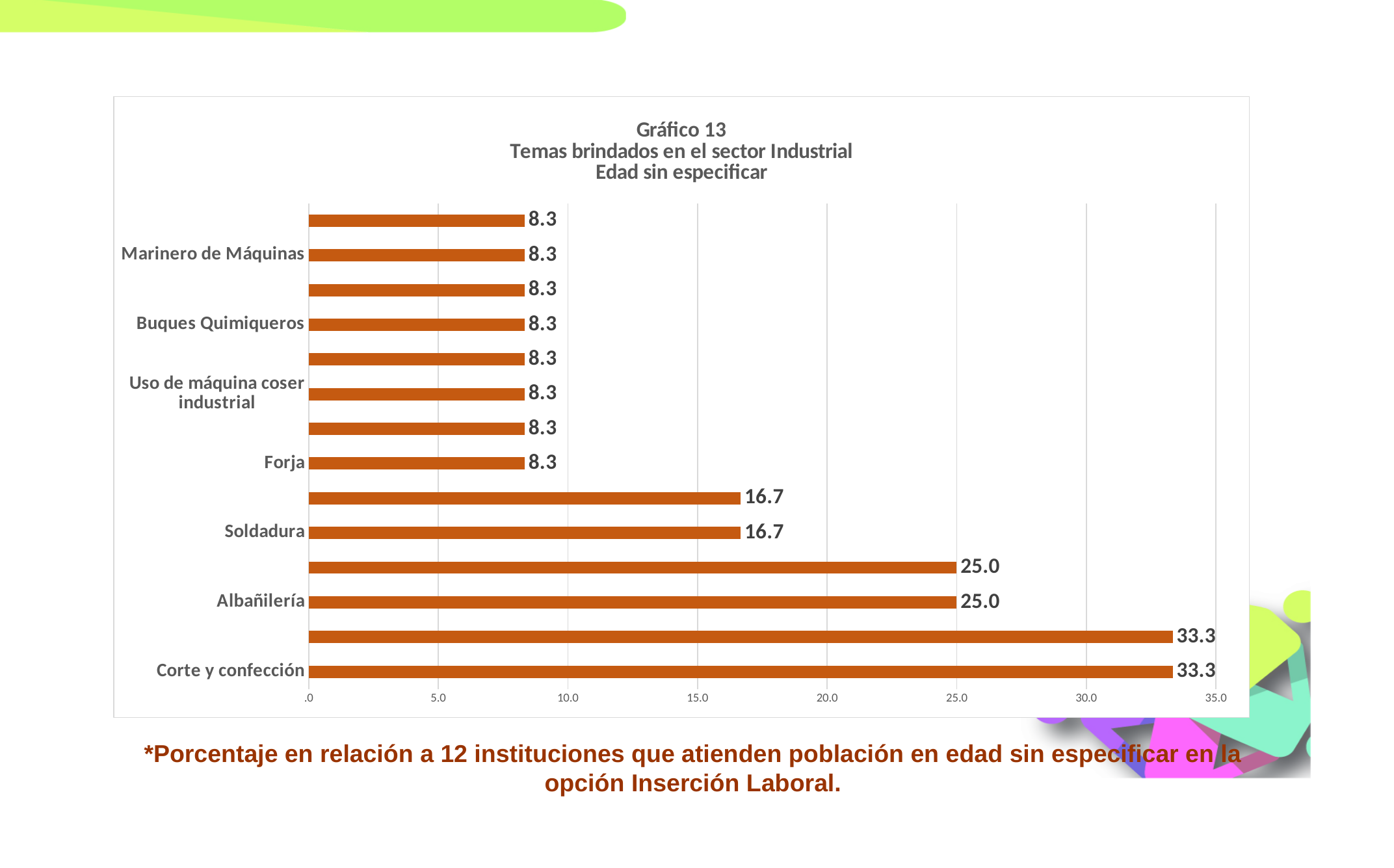
What is the value for Marinero de Máquinas? 8.3 How many bars are plotted in the chart? 14 Is the value for Soldadura greater or less than 15.0? greater What kind of chart is shown on the slide? bar chart What is the difference between the values for Corte y confección and Albañilería? 8.3 What is the difference between the values for Soldadura and Forja? 8.4 What is the value for Albañilería? 25.0 What is the value for Soldadura? 16.7 Which has a larger value, Albañilería or Soldadura? Albañilería What is the value for Corte y confección? 33.3 What is the number of the chart given in its title? Gráfico 13 What is the value for Forja? 8.3